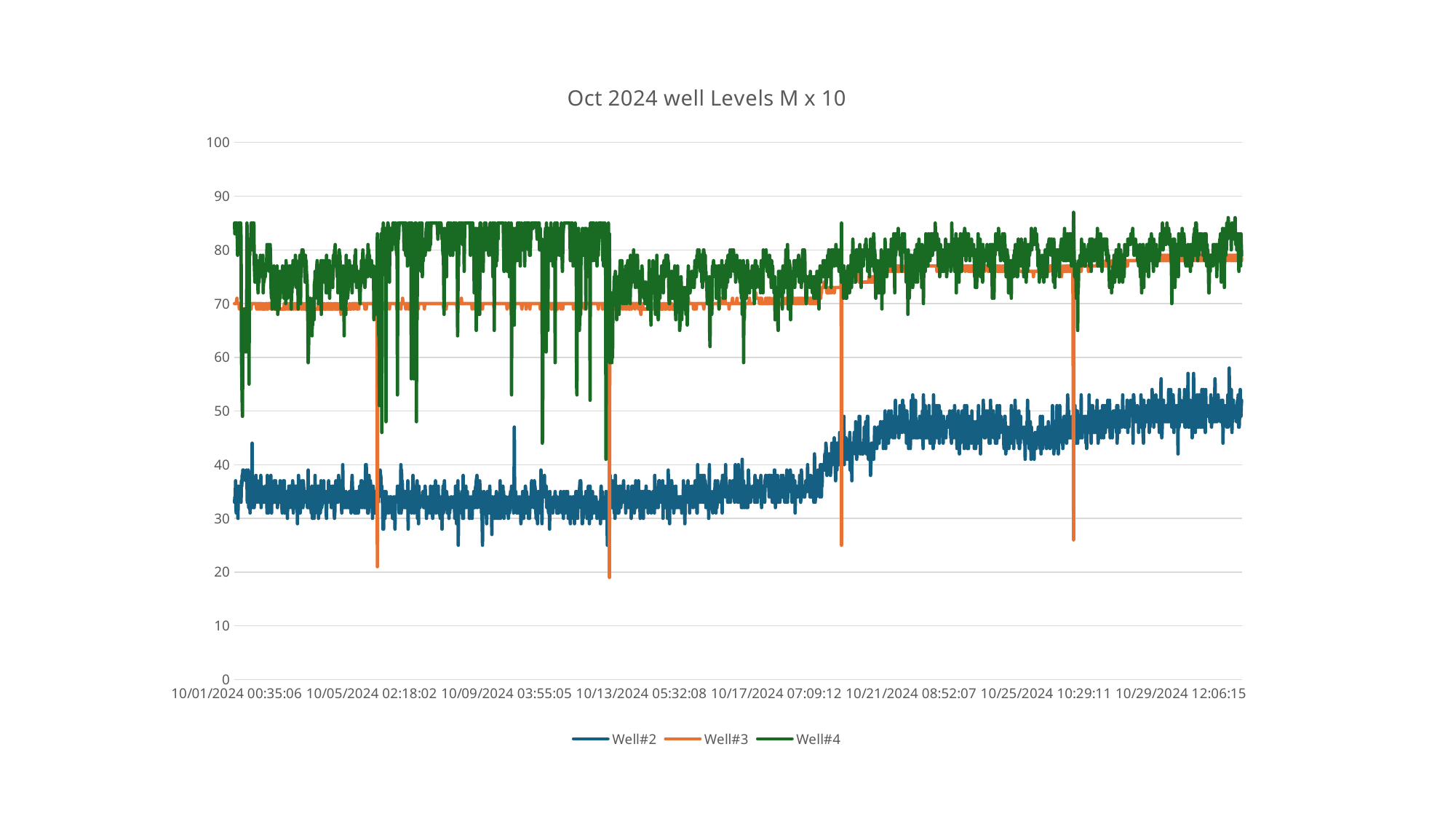
Which series generally has the lowest values across the chart? Well#2 Is the value for Well#3 at the start of the month (around 10/01/2024) greater or less than 60? greater Which series generally has the highest values across the chart? Well#4 How many series does the legend list? 3 What is the title of the chart? Oct 2024 well Levels M x 10 Is the value for Well#2 at the start of the month (around 10/01/2024) greater or less than 40? less What kind of chart is shown on the slide? line chart Does the Well#2 series generally rise or fall from the start of October to the end of October? rise How many date labels are shown along the x axis? 8 Is the value for Well#2 at the end of the month (around 10/29/2024) greater or less than 40? greater Which series is drawn in green? Well#4 Around 10/09/2024, which series has the larger value, Well#4 or Well#2? Well#4